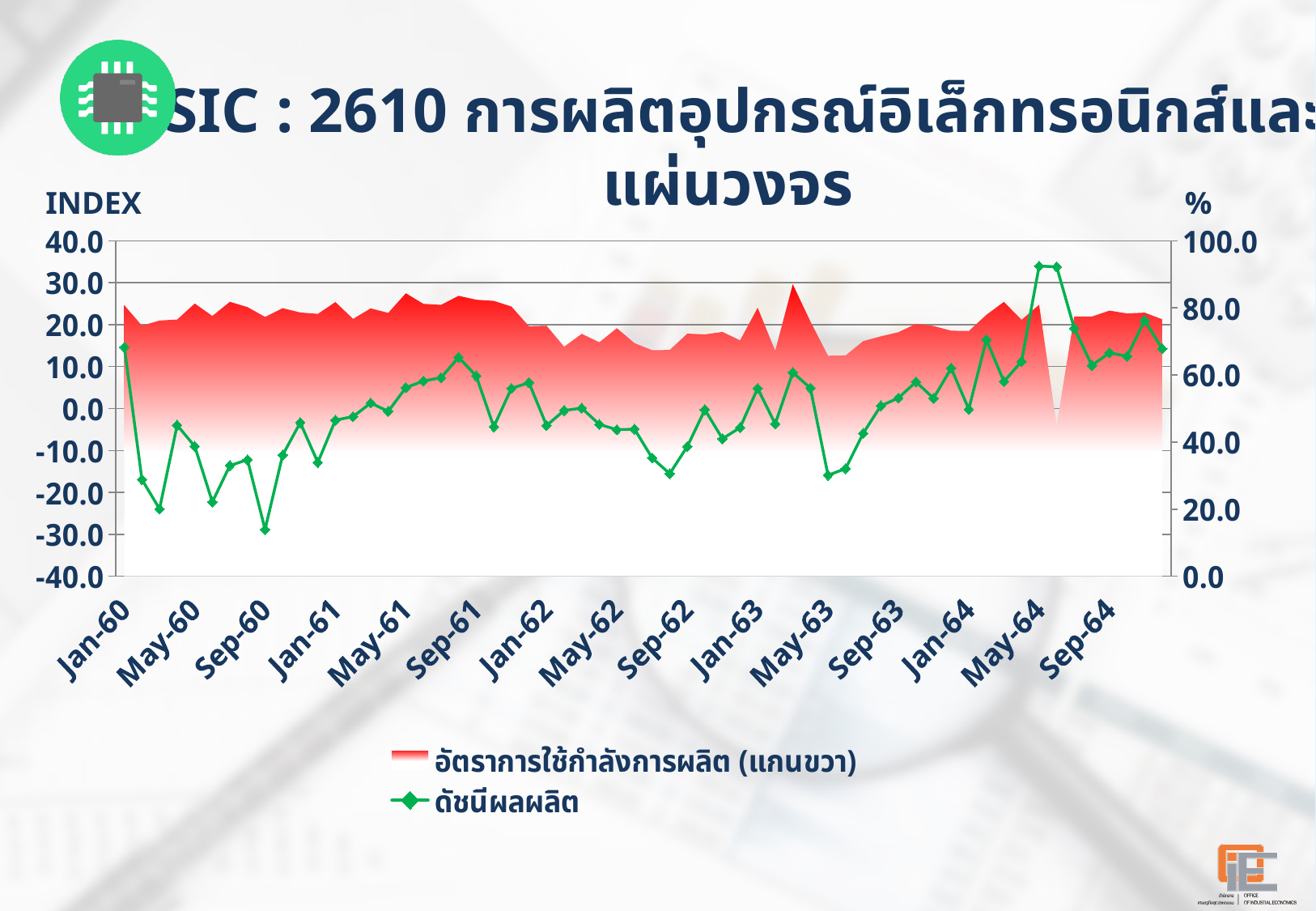
How many labels are shown on the x axis? 15 Is the value of the green line (ดัชนีผลผลิต) at May-64 greater or less than 30? greater How many series does the legend list? 2 What kind of chart is this? A combination of an area chart and a line chart Is the value of the green line (ดัชนีผลผลิต) at Sep-60 greater or less than -20? less What is the label of the right vertical axis? % Is the value of the green line (ดัชนีผลผลิต) at Jan-60 greater or less than 10? greater Around which x-axis label does the green line (ดัชนีผลผลิต) reach its highest point? May-64 Around which x-axis label does the green line (ดัชนีผลผลิต) reach its lowest point? Sep-60 Which is larger: the green line value at May-64 or at Sep-60? May-64 What is the label of the left vertical axis? INDEX